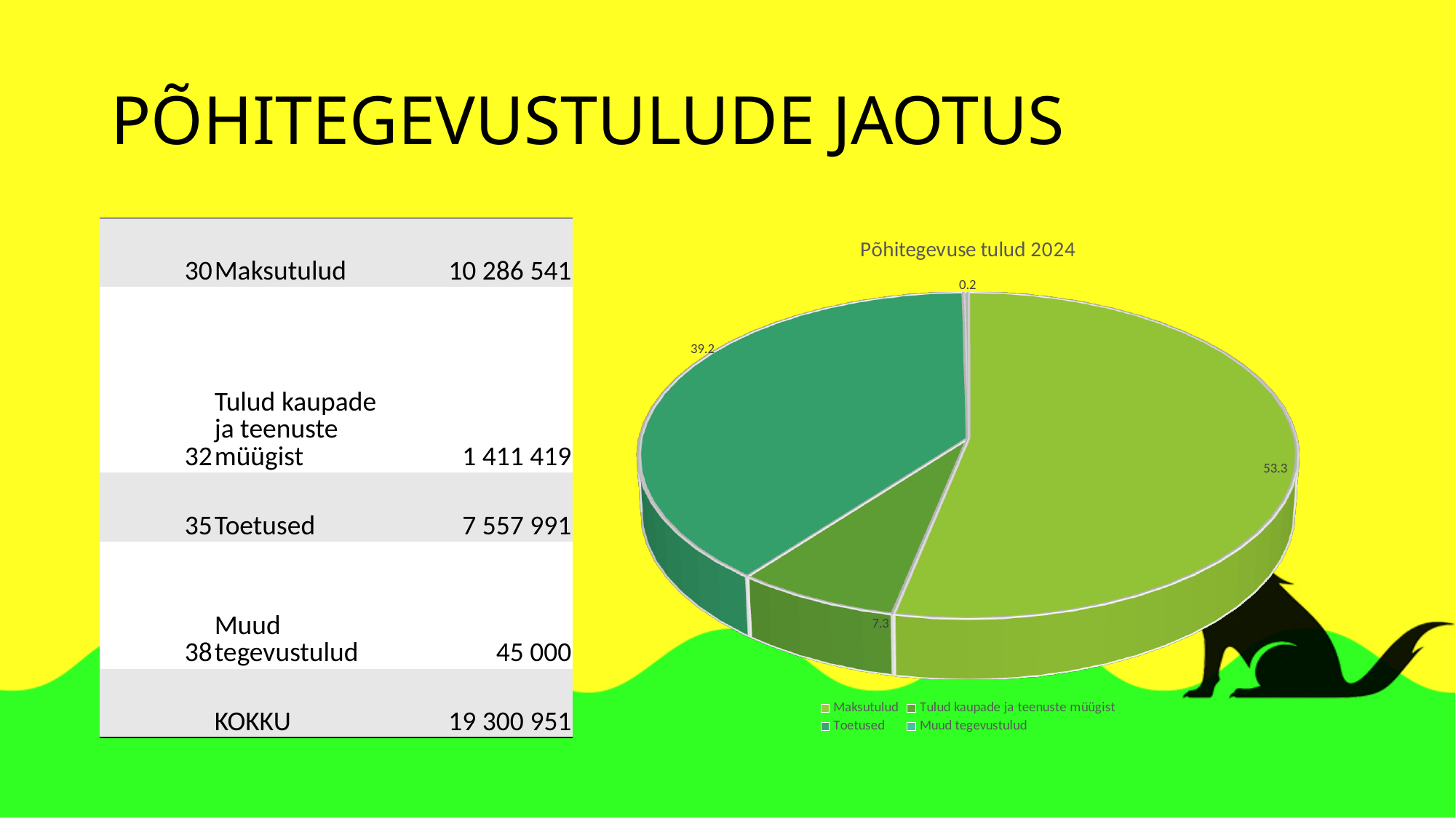
What is the difference between the Maksutulud and Toetused slice values? 14.1 Which slice of the pie chart is the smallest? Muud tegevustulud Which is larger, the Toetused slice or the Tulud kaupade ja teenuste müügist slice? Toetused What value is labelled on the Tulud kaupade ja teenuste müügist slice? 7.3 What value is labelled on the Toetused slice? 39.2 What value is labelled on the Muud tegevustulud slice? 0.2 What is the title of the chart? Põhitegevuse tulud 2024 What kind of chart is shown on the slide? pie chart Which slice of the pie chart is the largest? Maksutulud How many entries does the chart legend list? 4 How many slices does the pie chart have? 4 What value is labelled on the Maksutulud slice? 53.3